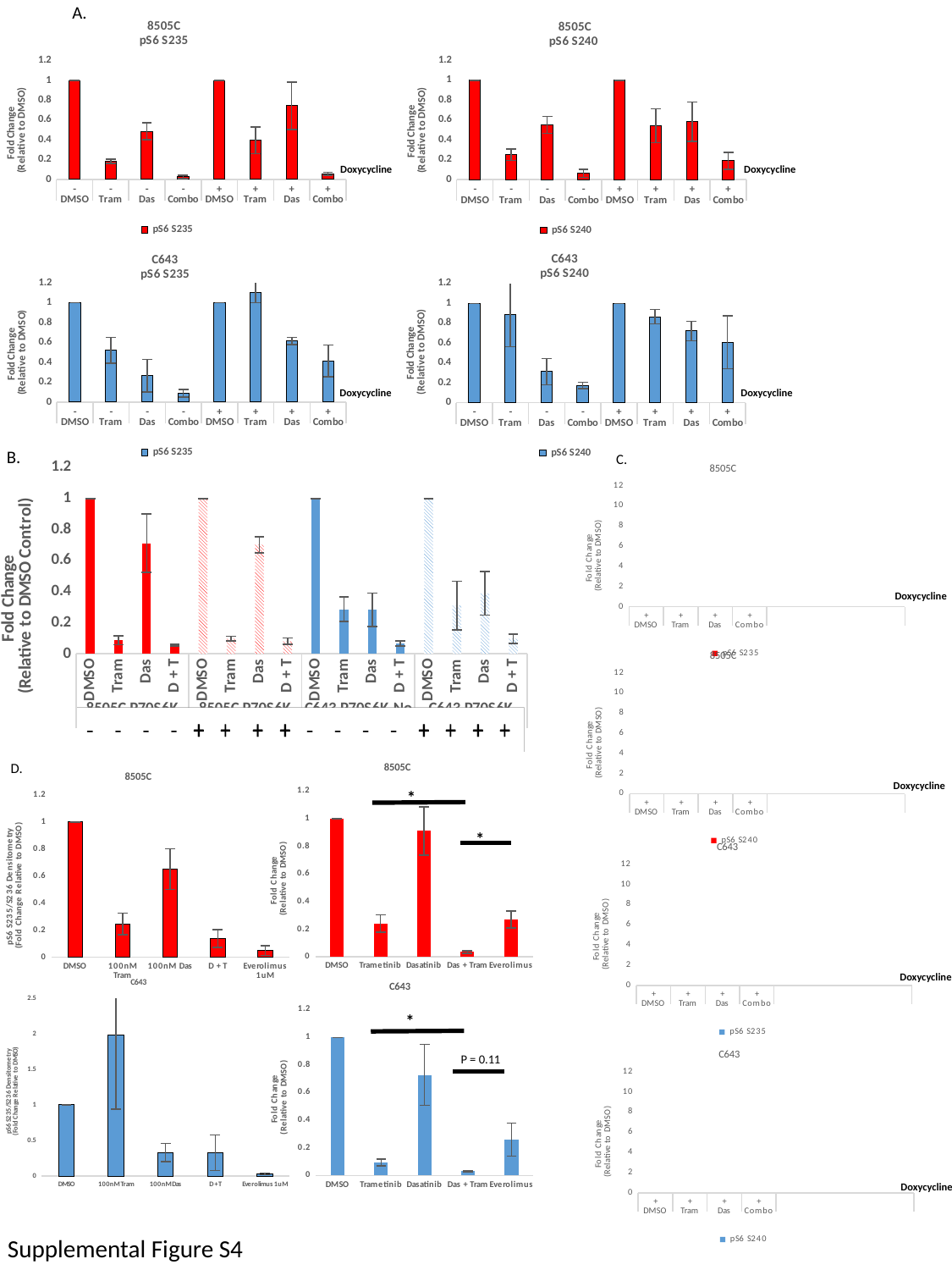
In panel A, how many series does the legend of the 8505C pS6 S235 chart list? 1 In panel D, in the bottom-left C643 chart, which category has the highest bar? 100nM Tram In panel D, in the top-left 8505C chart, is the value for Everolimus 1uM greater or less than 0.2? less In panel A, in the C643 pS6 S235 chart, which is larger without doxycycline (-): Tram or Das? Tram In panel D, in the bottom-right C643 chart, what P value is printed above the bars? P = 0.11 In panel A, what kind of chart is the 8505C pS6 S235 chart? bar chart In panel A, in the 8505C pS6 S235 chart, what is the fold change for the DMSO bar without doxycycline (-)? 1 In panel A, what is the legend entry of the 8505C pS6 S240 chart? pS6 S240 In panel A, in the 8505C pS6 S235 chart, is the value for Combo without doxycycline (-) greater or less than 0.2? less In panel D, in the top-right 8505C chart, is the value for Das + Tram greater or less than 0.2? less In panel A, in the 8505C pS6 S240 chart, which is larger with doxycycline (+): Tram or Combo? Tram In panel A, how many bars does the 8505C pS6 S235 chart show? 8